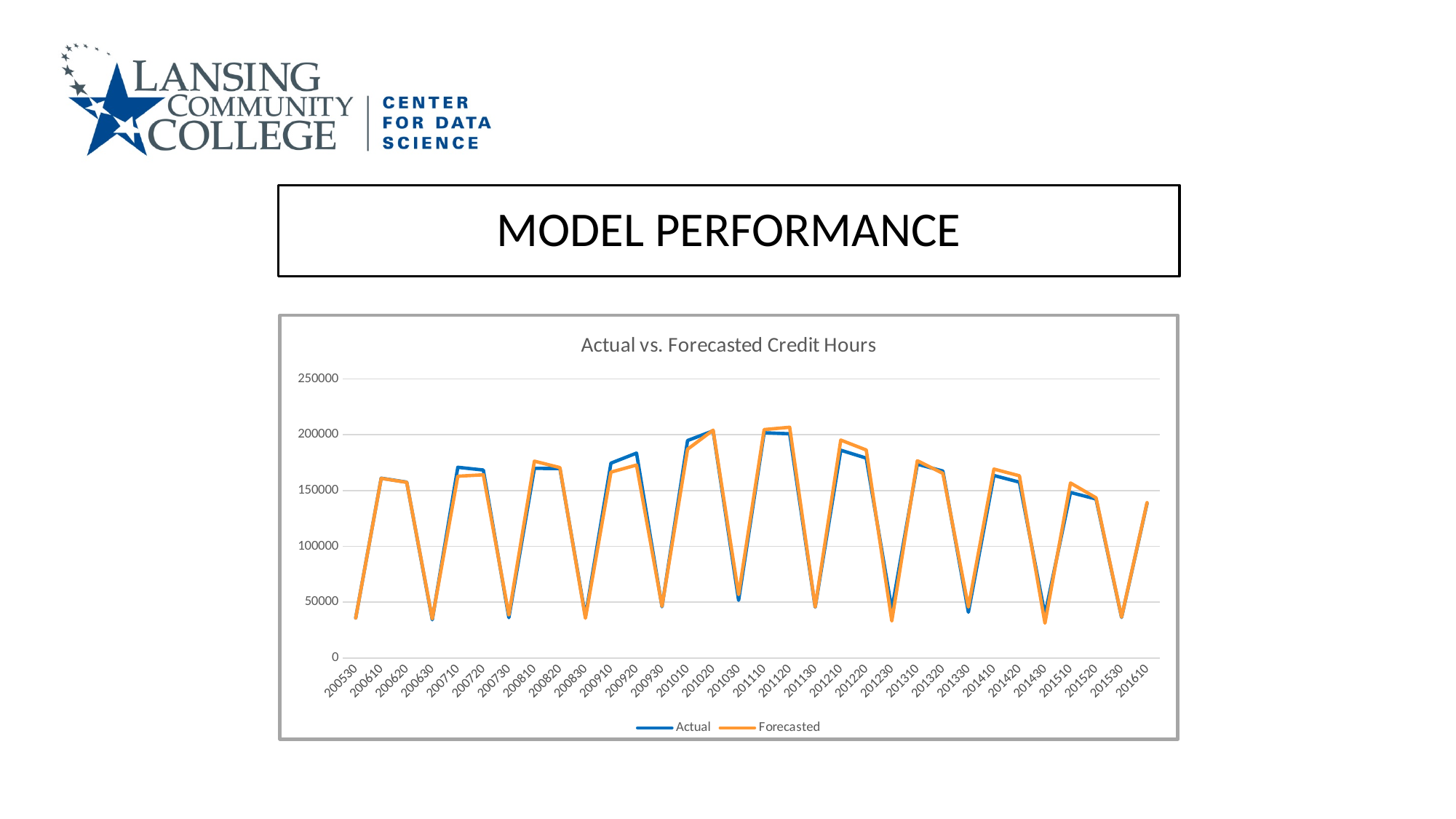
What is the title of the chart? Actual vs. Forecasted Credit Hours Is the Forecasted value for 201230 greater or less than 50000? less What kind of chart is shown on the slide? Line chart Is the Forecasted value for 200610 greater or less than 150000? greater Is the Forecasted value for 201120 greater or less than 200000? greater Which colour represents the Forecasted series in the chart? Orange At 201210, which is larger, the Actual value or the Forecasted value? Forecasted How many terms are labelled along the x axis of the chart? 32 Does the Actual series rise or fall from 201110 to 201130? Fall How many series does the chart's legend list? 2